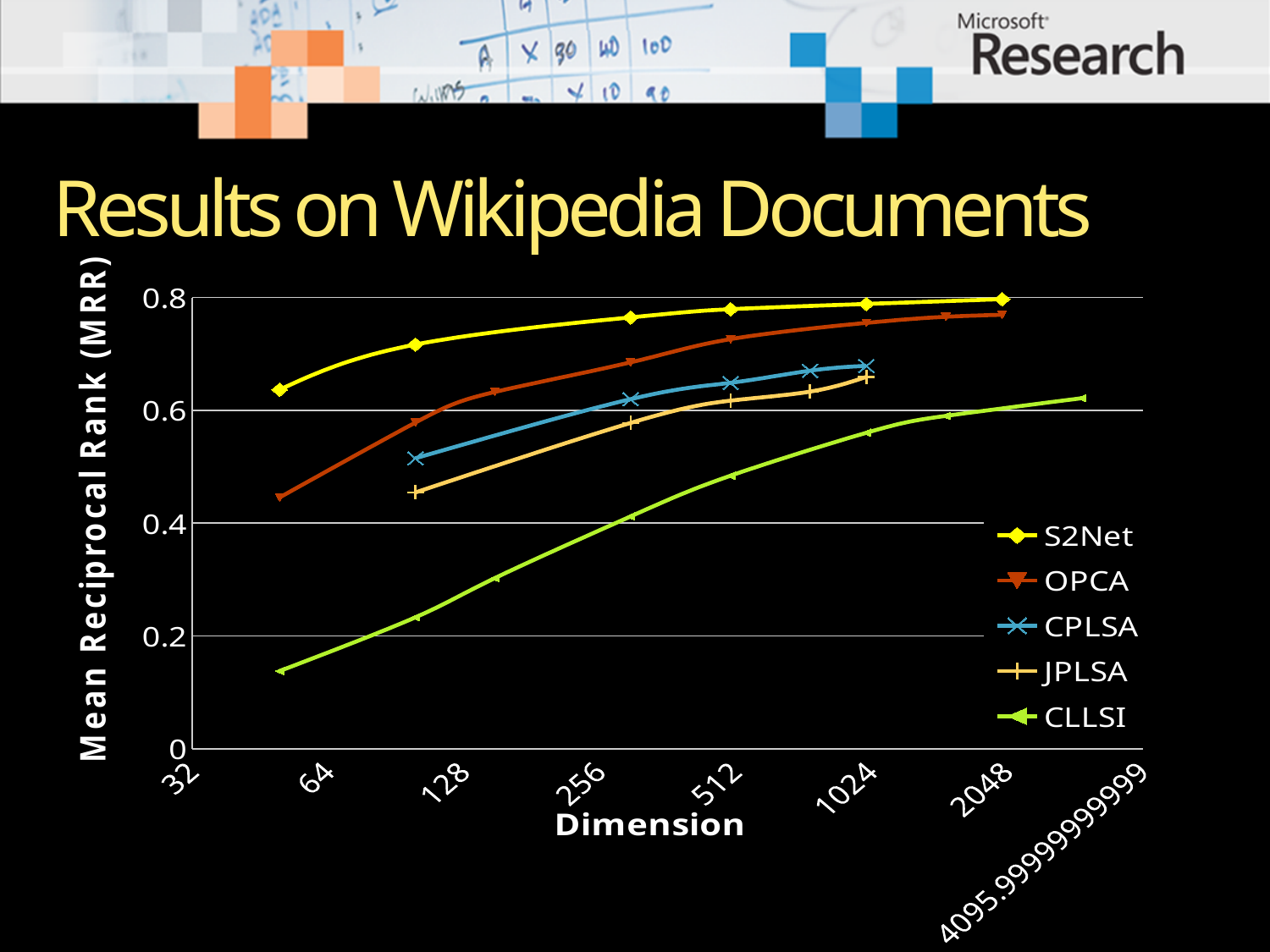
At their rightmost points, which series is higher, S2Net or OPCA? S2Net How many series does the legend list? 5 Is the leftmost value for OPCA greater or less than 0.4? greater Is the leftmost value for S2Net greater or less than 0.6? greater What is the label on the vertical axis? Mean Reciprocal Rank (MRR) What is the title of the slide's chart? Results on Wikipedia Documents Which series has the lowest MRR across the plotted dimensions? CLLSI Does the MRR for CLLSI rise or fall as the dimension increases? rise Which series has the highest MRR across the plotted dimensions? S2Net What kind of chart is shown on the slide? line chart Is the leftmost value for CLLSI greater or less than 0.2? less At their leftmost points, which series is higher, CPLSA or JPLSA? CPLSA